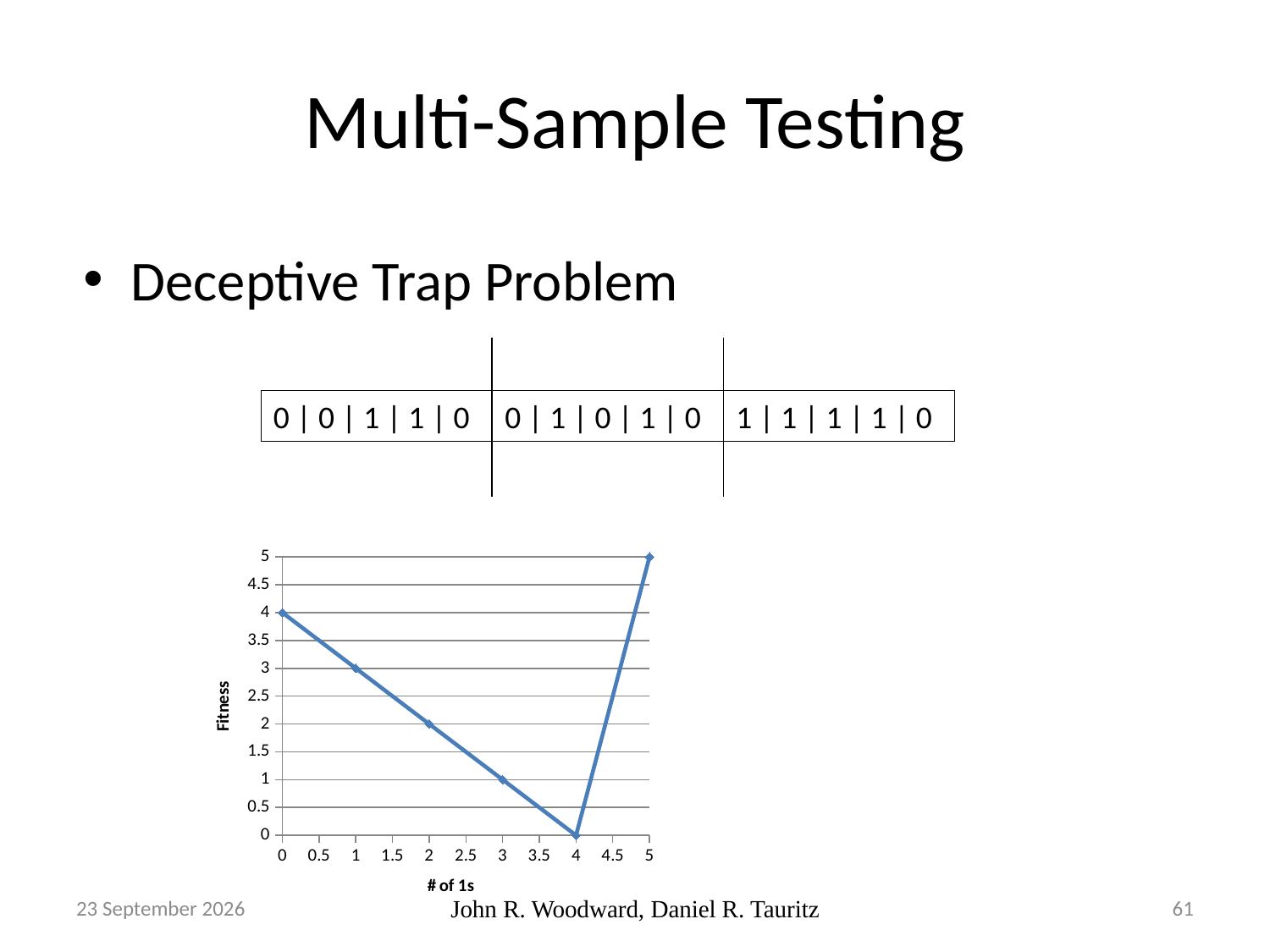
What kind of chart is shown on the slide? line chart How many data points are plotted on the chart? 6 At which # of 1s is Fitness highest? 5 What is the Fitness value when # of 1s is 0? 4 What is the Fitness value when # of 1s is 5? 5 Which has the higher Fitness: # of 1s = 0 or # of 1s = 3? # of 1s = 0 What is the label of the vertical axis of the chart? Fitness How does Fitness change as # of 1s increases from 0 to 4? It falls What is the Fitness value when # of 1s is 2? 2 What is the difference in Fitness between # of 1s = 5 and # of 1s = 4? 5 At which # of 1s is Fitness lowest? 4 What is the Fitness value when # of 1s is 4? 0